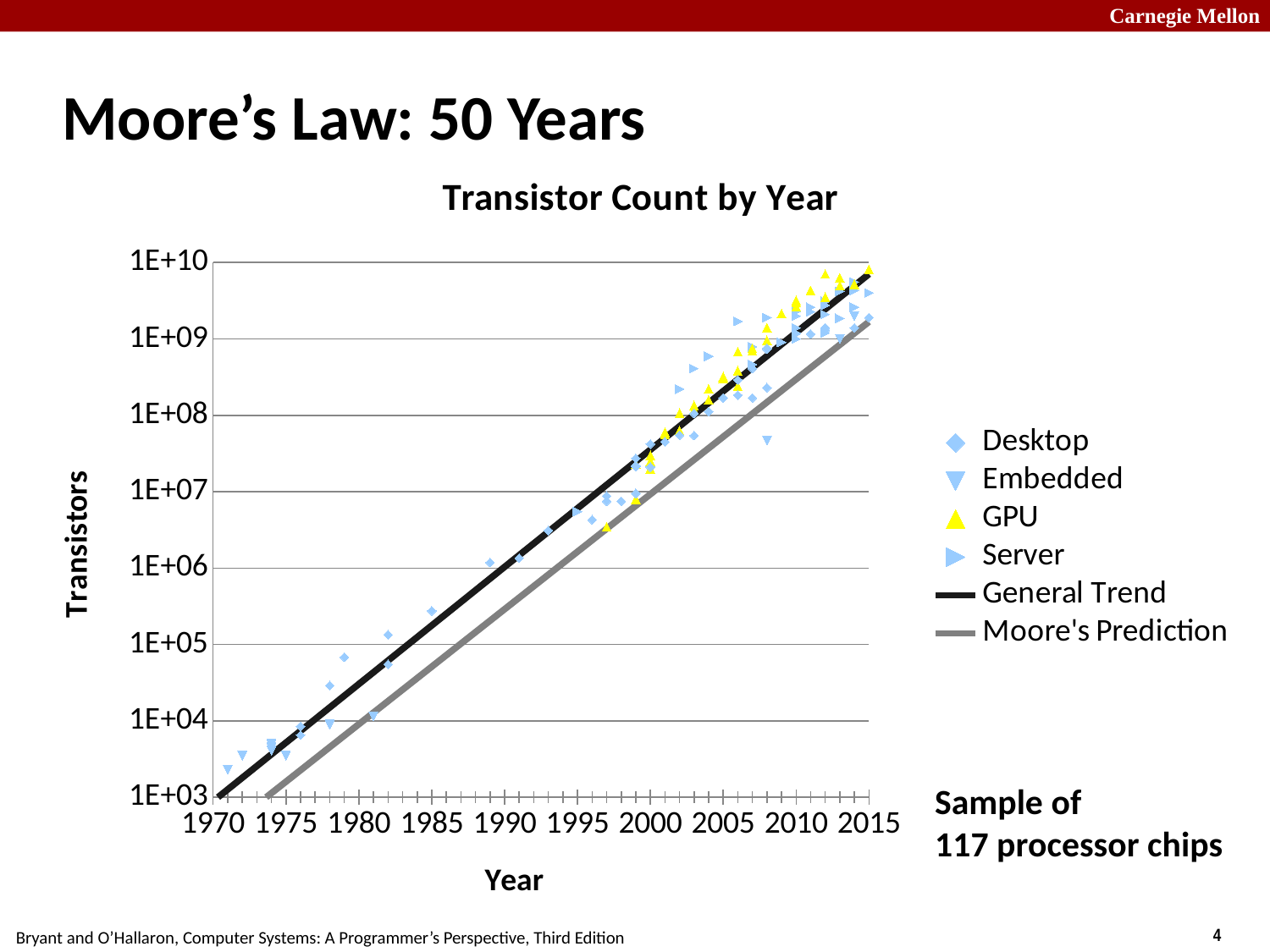
Is the General Trend line at 2015 greater or less than 1E+09 transistors? greater How many series does the legend list? 6 Is the Moore's Prediction line at 1990 greater or less than 1E+06 transistors? less What kind of chart is shown on the slide? scatter chart Is the General Trend line at 2000 greater or less than 1E+07 transistors? greater Do transistor counts rise or fall as the year increases along the x axis? rise Which line is higher on the chart, General Trend or Moore's Prediction? General Trend What is the highest value shown on the Transistors axis? 1E+10 What is the title of the chart? Transistor Count by Year What is the first year shown on the x axis? 1970 Which series is plotted with yellow triangles? GPU How many processor chips are in the sample plotted on the chart? 117